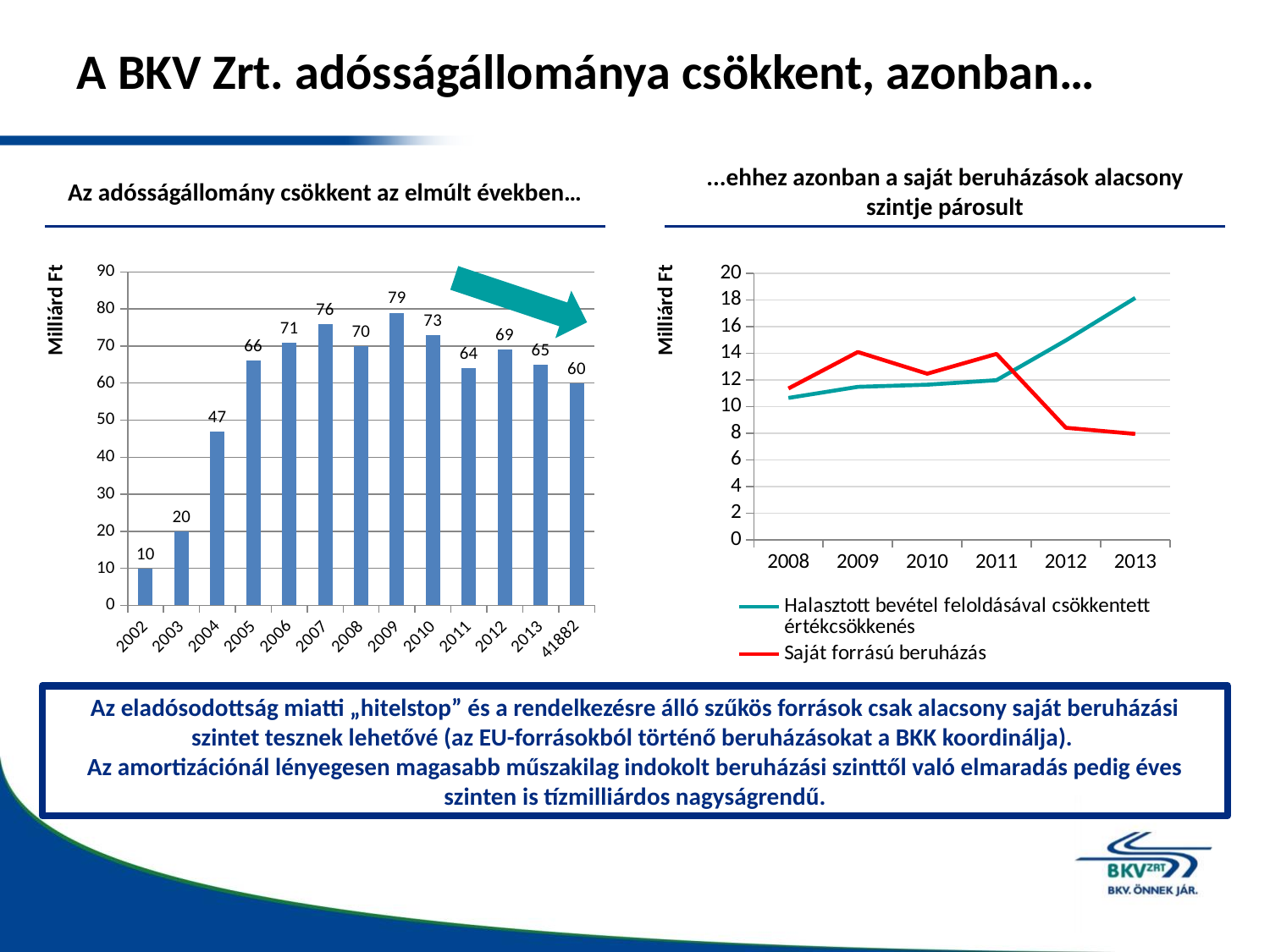
In the left chart (Az adósságállomány csökkent az elmúlt években…), how many bars are plotted? 13 In the left chart (Az adósságállomány csökkent az elmúlt években…), what is the value for 2004? 47 In the left chart (Az adósságállomány csökkent az elmúlt években…), which category has the lowest value? 2002 What kind of chart is the left chart (Az adósságállomány csökkent az elmúlt években…)? bar chart In the left chart (Az adósságállomány csökkent az elmúlt években…), what is the difference between the values for 2009 and 2013? 14 In the right chart (…ehhez azonban a saját beruházások alacsony szintje párosult), does the Halasztott bevétel feloldásával csökkentett értékcsökkenés series rise or fall from 2008 to 2013? rise In the left chart (Az adósságállomány csökkent az elmúlt években…), which year has the highest value? 2009 In the left chart (Az adósságállomány csökkent az elmúlt években…), what is the value for 2009? 79 In the right chart (…ehhez azonban a saját beruházások alacsony szintje párosult), what is the y-axis unit label? Milliárd Ft In the left chart (Az adósságállomány csökkent az elmúlt években…), which is larger, the value for 2007 or the value for 2010? 2007 In the right chart (…ehhez azonban a saját beruházások alacsony szintje párosult), is the value of Saját forrású beruházás in 2013 greater or less than 10? less In the right chart (…ehhez azonban a saját beruházások alacsony szintje párosult), how many series does the legend list? 2